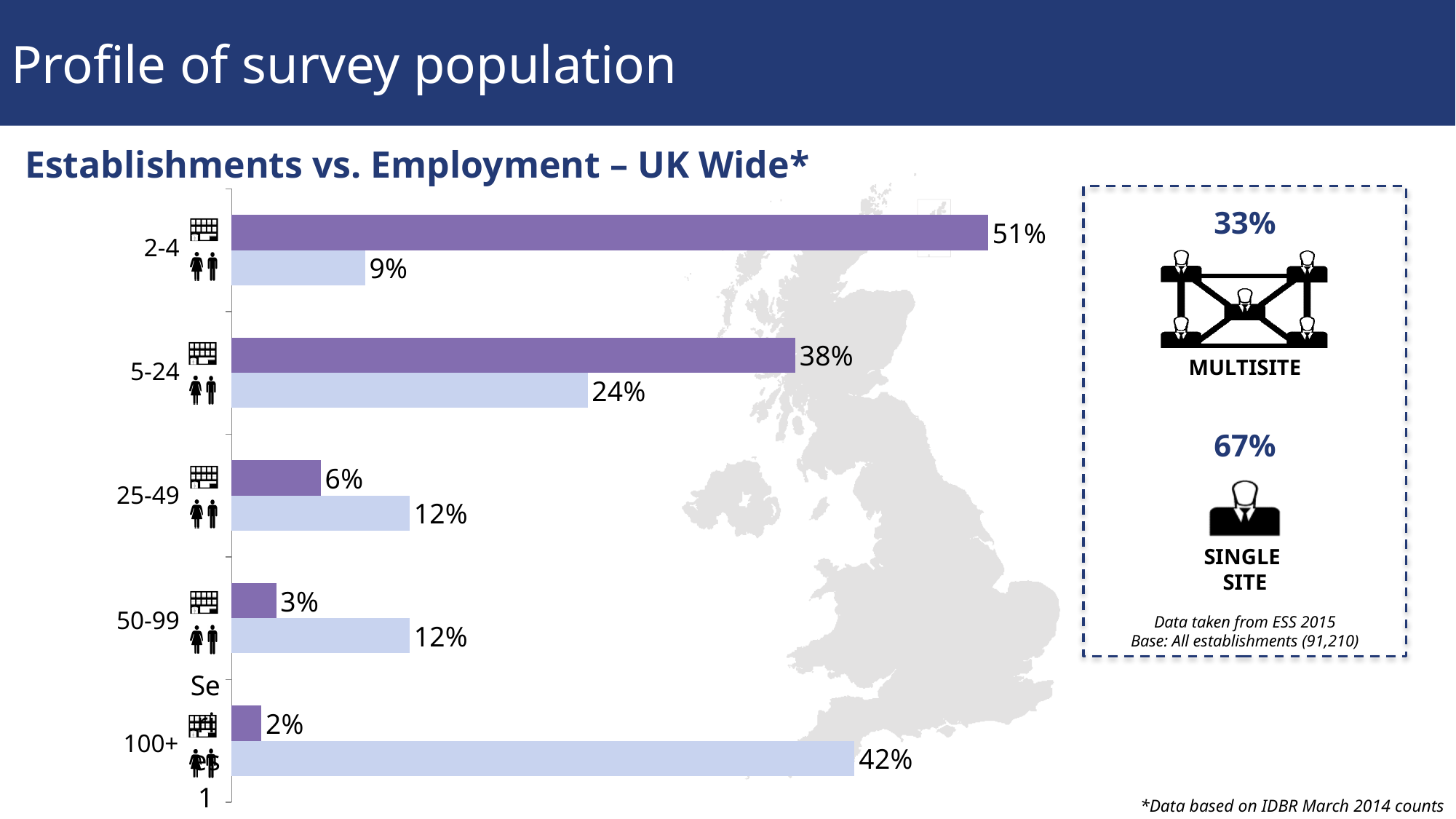
What is the value of the light blue (employment) bar for the 100+ size band? 42% What is the difference between the dark purple and light blue bars for the 2-4 size band? 42 percentage points What type of chart is shown on the slide? bar chart Which size band has the highest dark purple (establishments) value? 2-4 What is the difference between the light blue (employment) values for 100+ and 5-24? 18 percentage points What is the value of the dark purple (establishments) bar for the 2-4 size band? 51% What is the title of the chart? Establishments vs. Employment – UK Wide* What is the value of the dark purple (establishments) bar for the 50-99 size band? 3% For the 25-49 size band, which bar is larger: the dark purple (establishments) or the light blue (employment)? light blue (employment) Which size band has the lowest light blue (employment) value? 2-4 How many size bands are shown on the chart? 5 What is the value of the light blue (employment) bar for the 5-24 size band? 24%